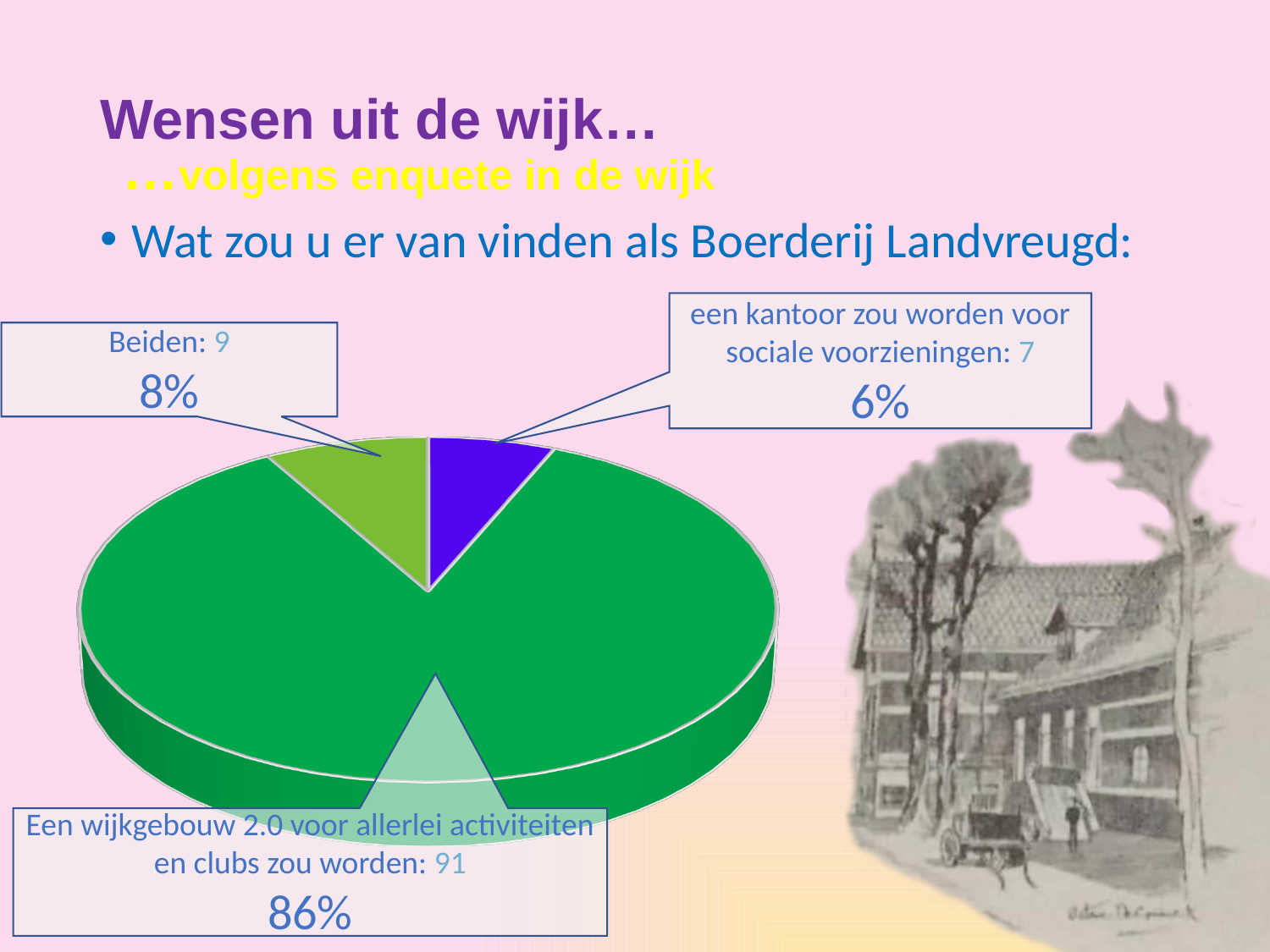
Which slice of the pie chart is the largest? Een wijkgebouw 2.0 voor allerlei activiteiten en clubs zou worden Which has a larger count: 'Beiden' or 'een kantoor zou worden voor sociale voorzieningen'? Beiden What kind of chart is shown on the slide? pie chart Which slice of the pie chart is the smallest? een kantoor zou worden voor sociale voorzieningen What colour is the 'Beiden' slice of the pie chart? light green What percentage of the pie is the slice 'Een wijkgebouw 2.0 voor allerlei activiteiten en clubs zou worden'? 86% What is the difference in count between 'Beiden' and 'een kantoor zou worden voor sociale voorzieningen'? 2 What count is shown for 'Een wijkgebouw 2.0 voor allerlei activiteiten en clubs zou worden'? 91 What count is shown for 'Beiden'? 9 How many slices does the pie chart have? 3 What count is shown for 'een kantoor zou worden voor sociale voorzieningen'? 7 What percentage is shown for 'een kantoor zou worden voor sociale voorzieningen'? 6%